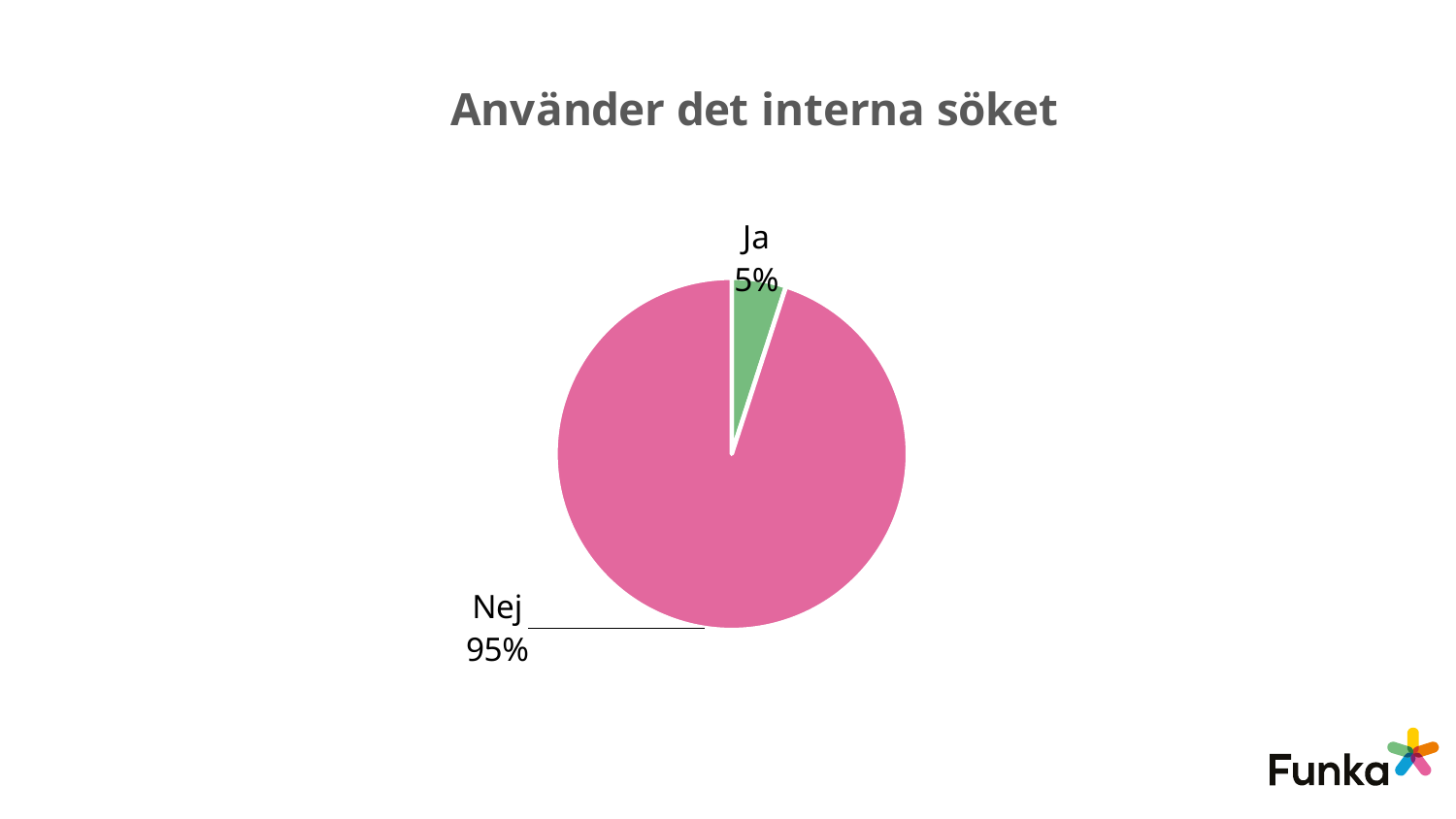
What share of the pie is labelled "Nej"? 95% Which slice is the smallest? Ja How many slices does the pie chart have? 2 What kind of chart is shown on the slide? pie chart What share of the pie is labelled "Ja"? 5% What is the total of the two slice percentages shown? 100% Which slice is the largest? Nej What is the title of the chart? Använder det interna söket Which is larger, the "Ja" slice or the "Nej" slice? Nej What colour is the "Ja" slice? green What is the difference in percentage points between the "Nej" and "Ja" slices? 90